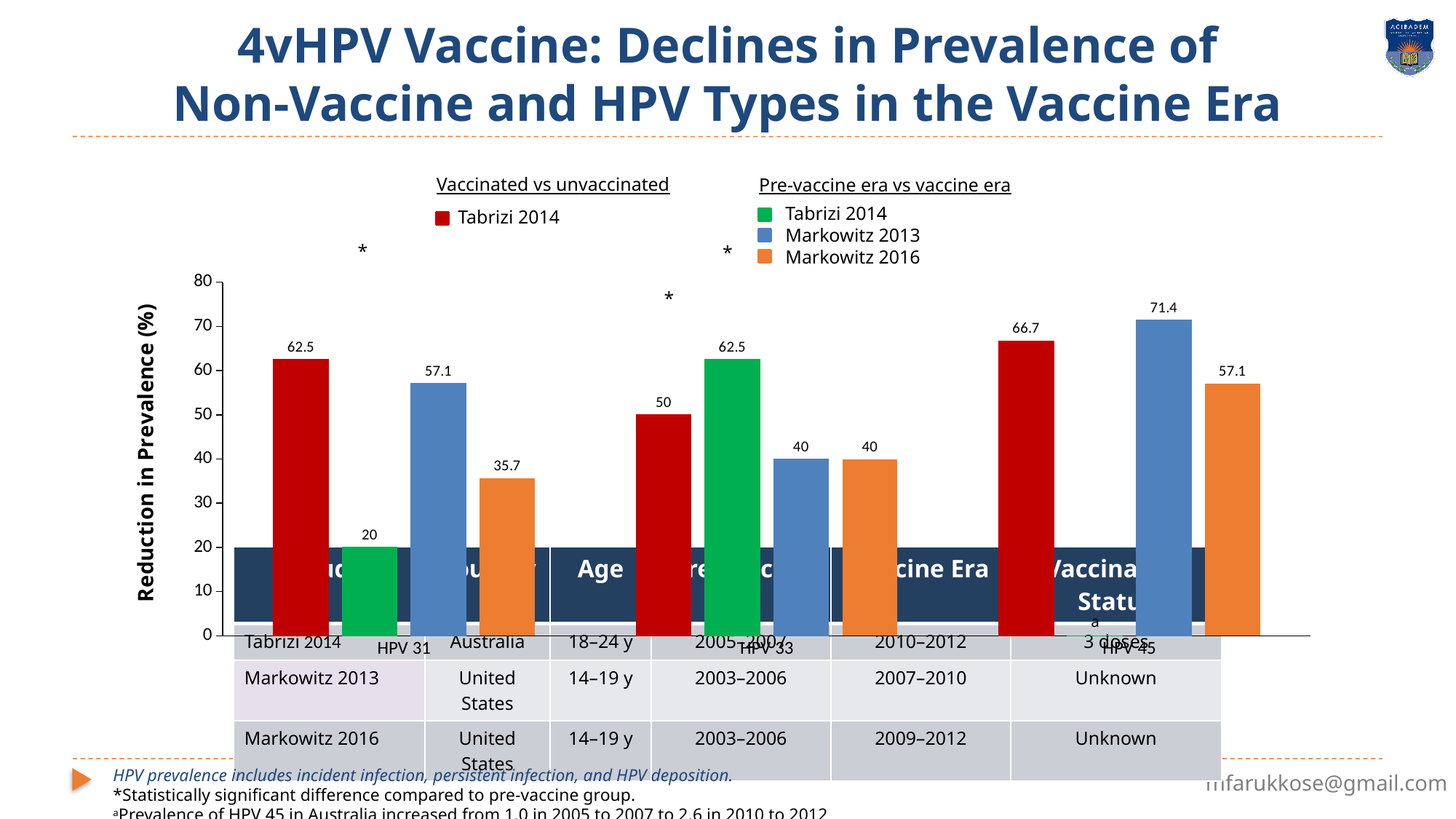
What is the reduction in prevalence for HPV 33 in the Tabrizi 2014 pre-vaccine era vs vaccine era (green) series? 62.5 How many HPV type categories are shown on the x axis? 3 What type of chart is shown on the slide? bar chart Which bar shows the lowest reduction in prevalence on the chart? Tabrizi 2014 pre-vaccine era vs vaccine era (green) for HPV 31 (20) For HPV 31, what is the difference between the Markowitz 2013 value and the Markowitz 2016 value? 21.4 What is the reduction in prevalence for HPV 31 in the Markowitz 2016 series? 35.7 What is the label of the y axis? Reduction in Prevalence (%) What is the reduction in prevalence for HPV 31 in the Tabrizi 2014 vaccinated vs unvaccinated (red) series? 62.5 What is the reduction in prevalence for HPV 45 in the Markowitz 2013 series? 71.4 Which bar shows the highest reduction in prevalence on the chart? Markowitz 2013 for HPV 45 (71.4) For HPV 45, which series has the larger value: Markowitz 2013 or Markowitz 2016? Markowitz 2013 Is the Markowitz 2016 value for HPV 33 greater or less than 50? less